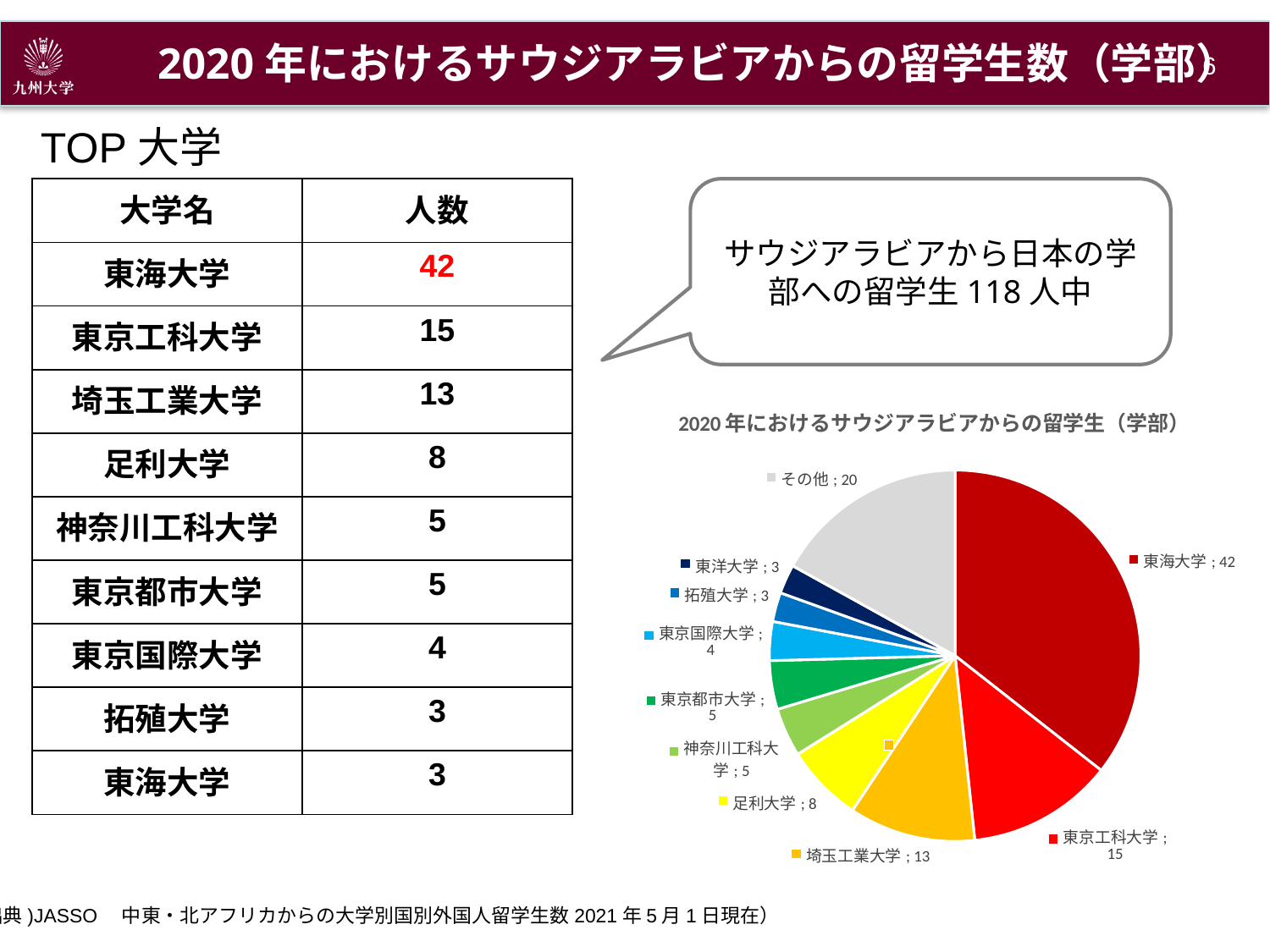
Which university has the largest slice in the pie chart? 東海大学 What is the total of all slices in the pie chart? 118 What is the value for 埼玉工業大学 in the pie chart? 13 What is the value for 東京国際大学 in the pie chart? 4 What is the value of the その他 slice in the pie chart? 20 What kind of chart is shown on the slide? pie chart How many slices does the pie chart have? 10 What is the title of the pie chart? 2020年におけるサウジアラビアからの留学生（学部） What is the value for 東京工科大学 in the pie chart? 15 What is the difference between the values for 東海大学 and 東京工科大学 in the pie chart? 27 How many students does the pie chart show for 東海大学? 42 Which has the larger value in the pie chart, 埼玉工業大学 or 足利大学? 埼玉工業大学